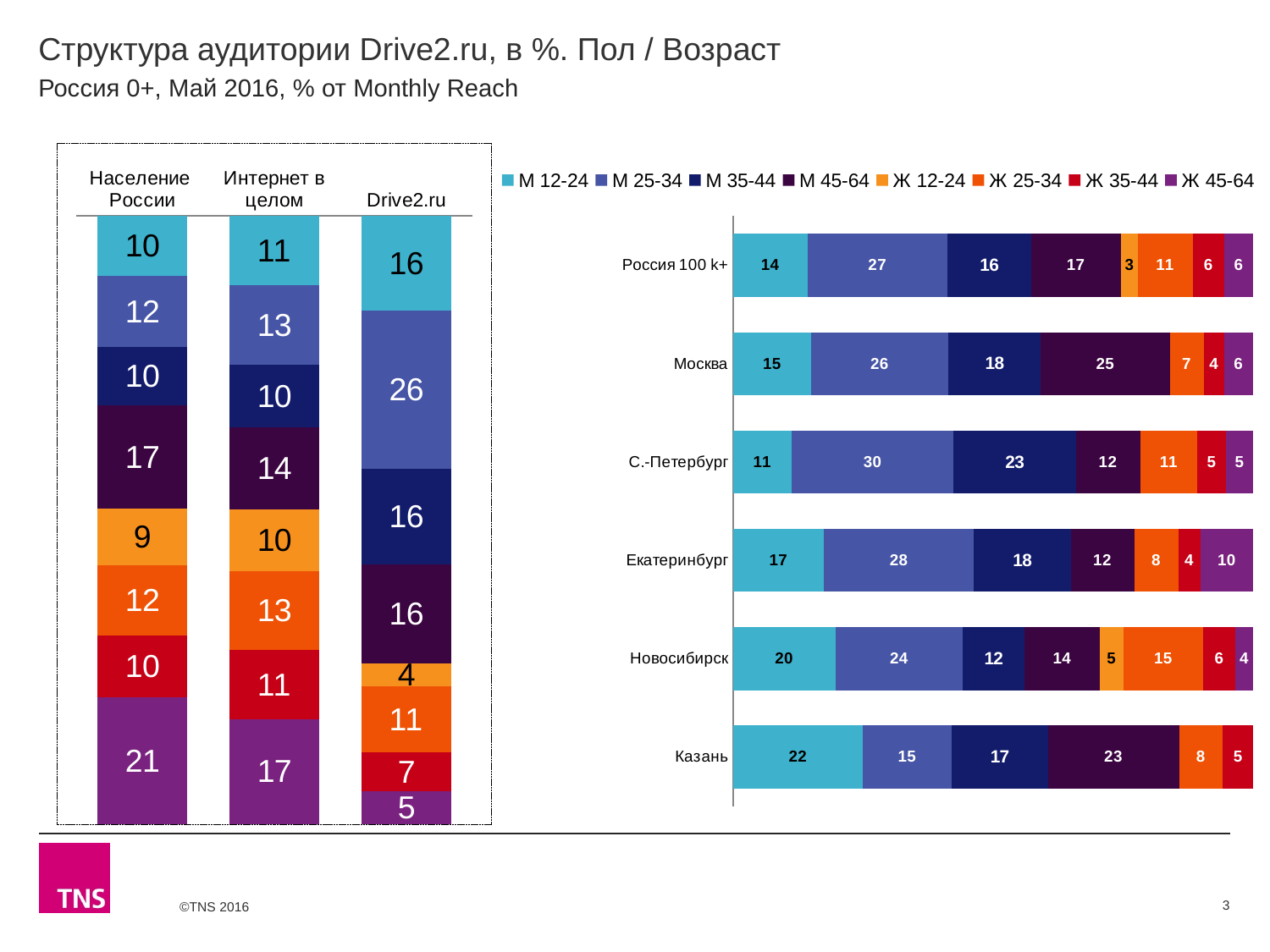
In the left chart, what is the value of the М 25-34 segment for Drive2.ru? 26 In the left chart, what is the value of the Ж 45-64 segment for Население России? 21 In the right chart, what is the value of the Ж 25-34 segment for Новосибирск? 15 In the left chart, which is larger: the Ж 45-64 value for Интернет в целом or for Drive2.ru? Интернет в целом How many series does the legend list? 8 In the right chart, what is the value of the М 25-34 segment for С.-Петербург? 30 In the right chart, what is the difference between the М 45-64 values for Москва and С.-Петербург? 13 What type of chart is the right chart? Stacked bar chart In the right chart, what is the value of the М 12-24 segment for Казань? 22 How many cities/regions are shown in the right chart? 6 In the right chart, which city has the lowest М 25-34 value? Казань In the right chart, which city has the highest М 12-24 value? Казань